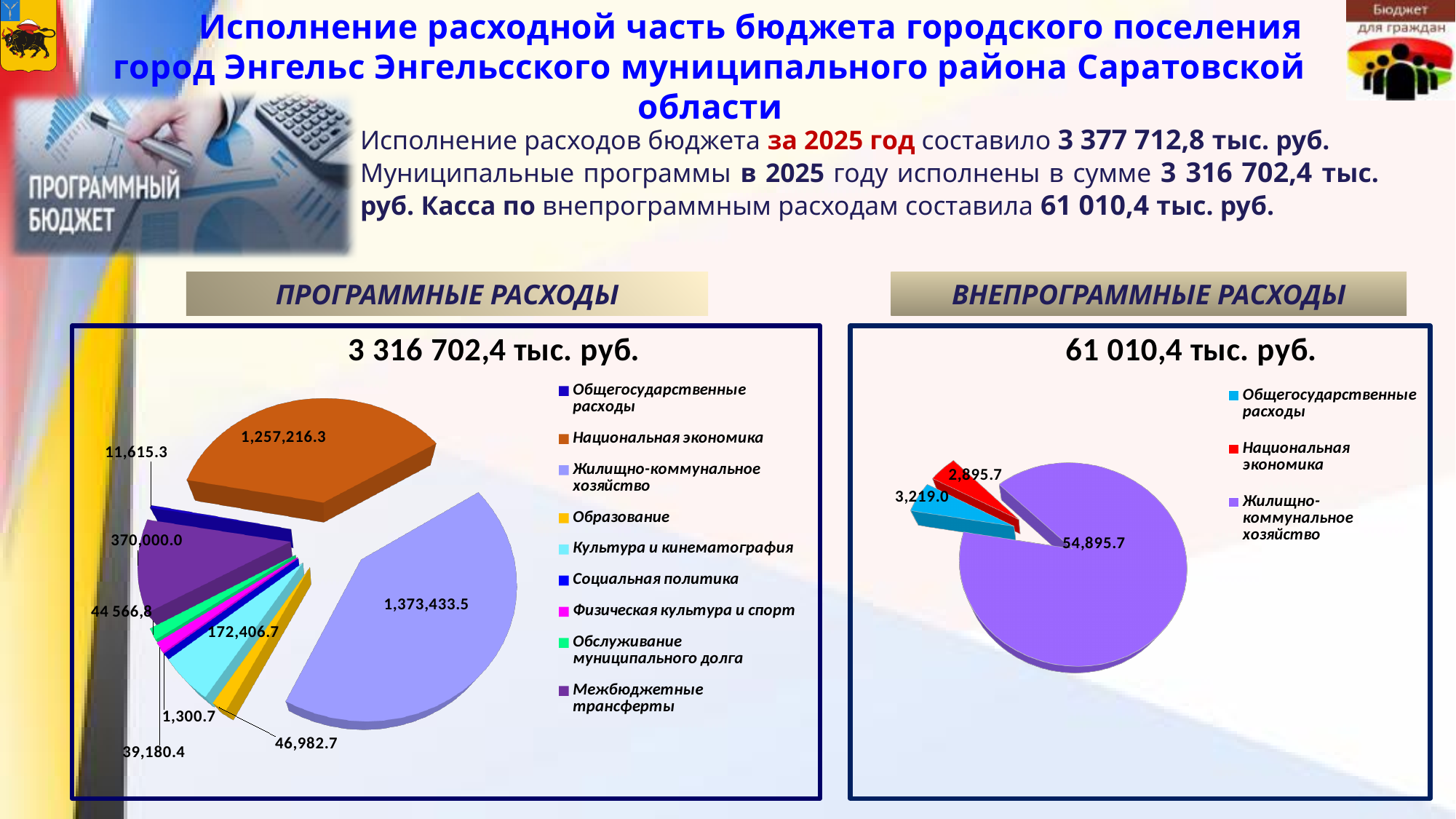
What kind of chart is the ПРОГРАММНЫЕ РАСХОДЫ chart on the left? Pie chart How many categories does the legend of the ПРОГРАММНЫЕ РАСХОДЫ chart list? 9 In the ПРОГРАММНЫЕ РАСХОДЫ chart, what is the value for Национальная экономика? 1,257,216.3 In the ПРОГРАММНЫЕ РАСХОДЫ chart, which category has the largest slice? Жилищно-коммунальное хозяйство How many categories does the legend of the ВНЕПРОГРАММНЫЕ РАСХОДЫ chart list? 3 In the ВНЕПРОГРАММНЫЕ РАСХОДЫ chart, which category has the smallest slice? Национальная экономика In the ВНЕПРОГРАММНЫЕ РАСХОДЫ chart, what is the difference between Общегосударственные расходы and Национальная экономика? 323.3 What total amount is shown above the ВНЕПРОГРАММНЫЕ РАСХОДЫ chart? 61 010,4 тыс. руб. In the ВНЕПРОГРАММНЫЕ РАСХОДЫ chart, what is the value for Жилищно-коммунальное хозяйство? 54,895.7 In the ПРОГРАММНЫЕ РАСХОДЫ chart, what is the difference between Жилищно-коммунальное хозяйство and Национальная экономика? 116,217.2 In the ПРОГРАММНЫЕ РАСХОДЫ chart, what is the value for Межбюджетные трансферты? 370,000.0 In the ВНЕПРОГРАММНЫЕ РАСХОДЫ chart, what is the value for Национальная экономика? 2,895.7